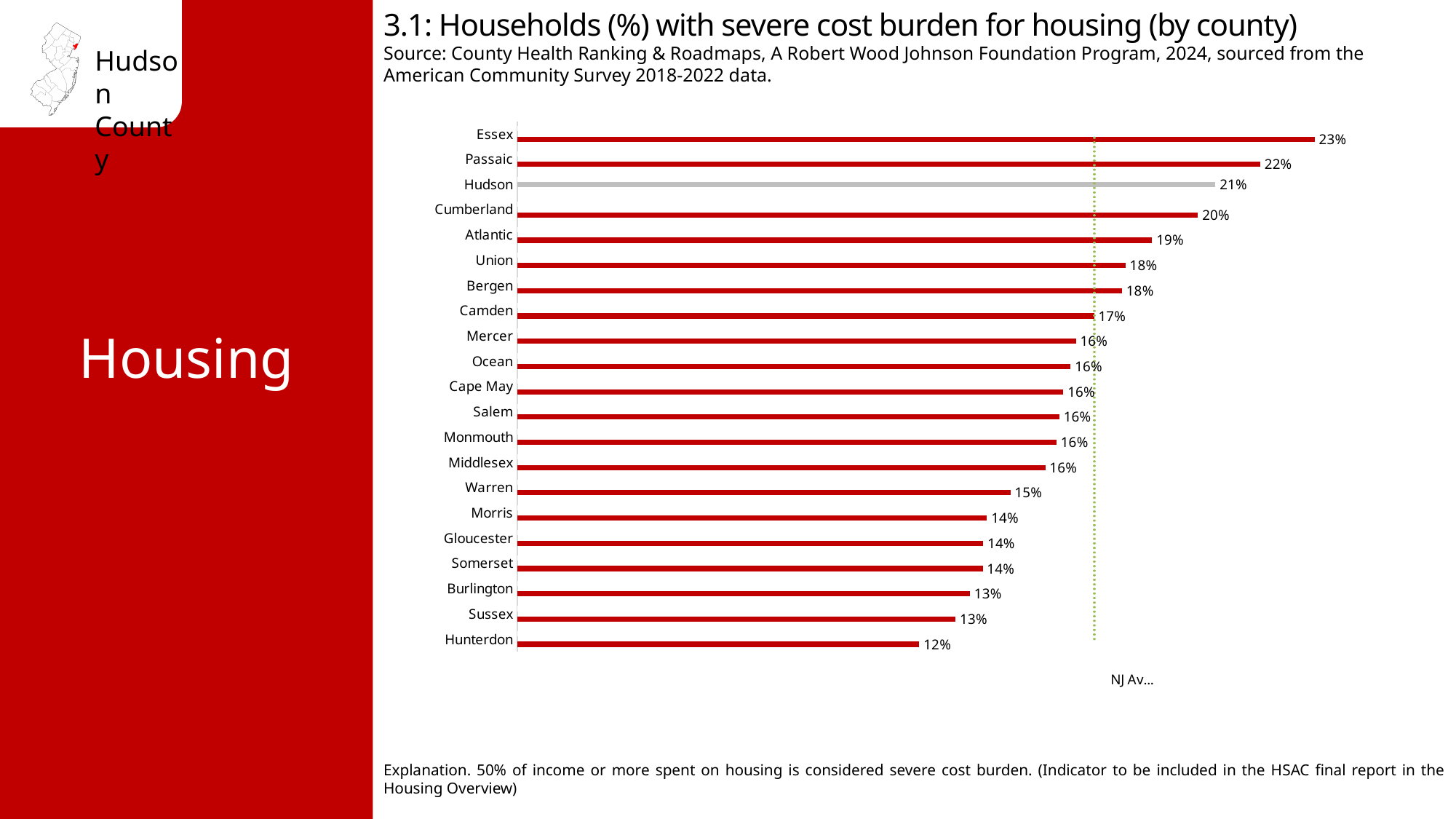
How many counties are shown in the chart? 21 What is the value for Cumberland? 20% What kind of chart is shown on the slide? Bar chart What is the difference between the values for Essex and Hunterdon? 11% What is the difference between the values for Hudson and Warren? 6% Which county has the highest value? Essex Which is larger, the value for Passaic or the value for Atlantic? Passaic Which county has the lowest value? Hunterdon What is the value for Hudson? 21% What is the value for Essex? 23% Which county's bar is shown in grey rather than red? Hudson What is the value for Hunterdon? 12%